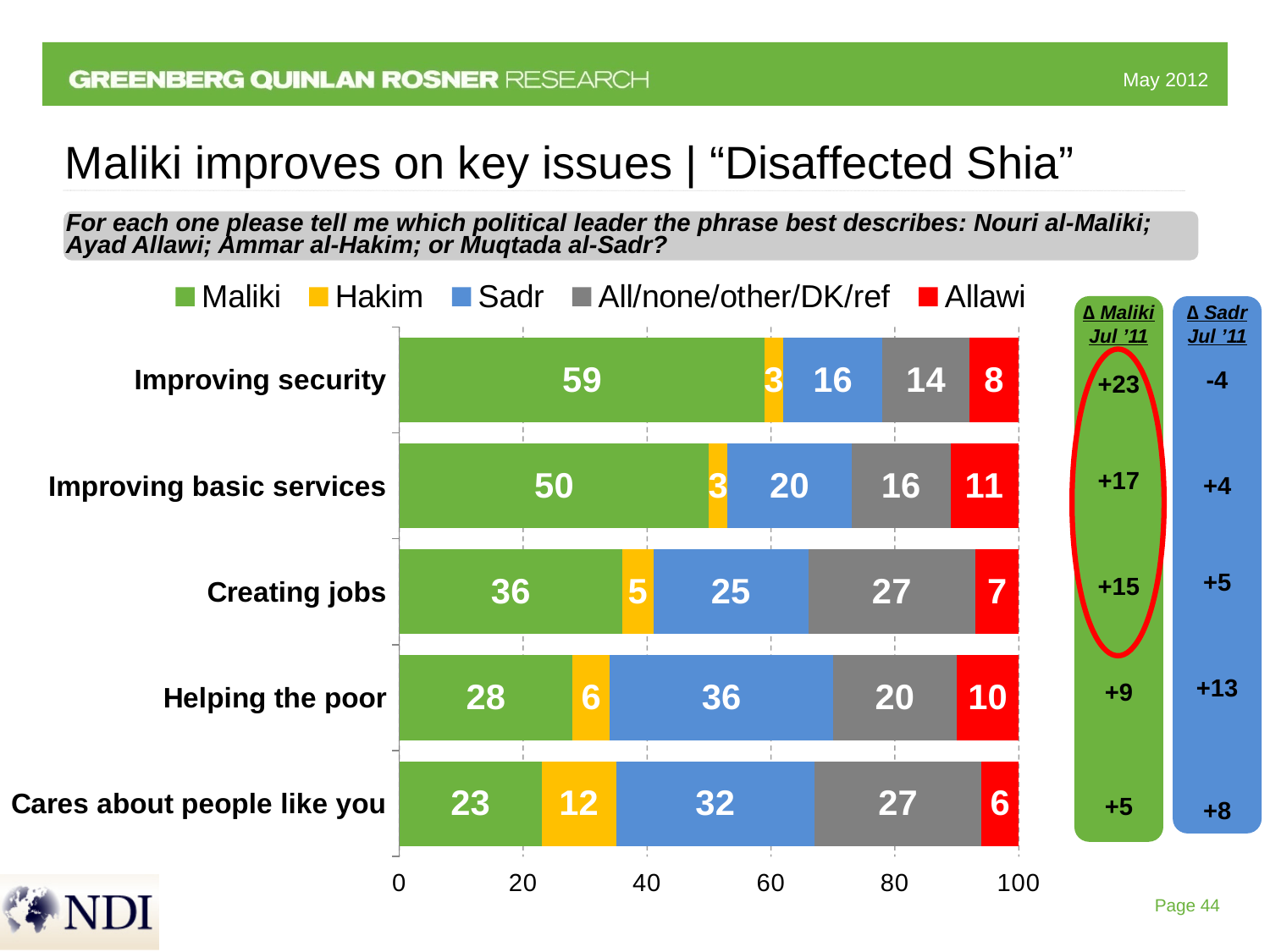
Which is larger for "Helping the poor": the Maliki value or the Sadr value? Sadr What is the Sadr value for "Helping the poor"? 36 What is the Hakim value for "Cares about people like you"? 12 What is the total of the stacked bar for "Creating jobs"? 100 What is the difference between the Maliki value for "Improving security" and the Maliki value for "Creating jobs"? 23 What kind of chart is shown on the slide? Stacked bar chart How many categories (issues) are plotted on the chart? 5 What is the Maliki value for "Improving security"? 59 For which category is the Maliki value lowest? Cares about people like you How many series does the legend list? 5 What is the Allawi value for "Improving basic services"? 11 For which category is the Maliki value highest? Improving security